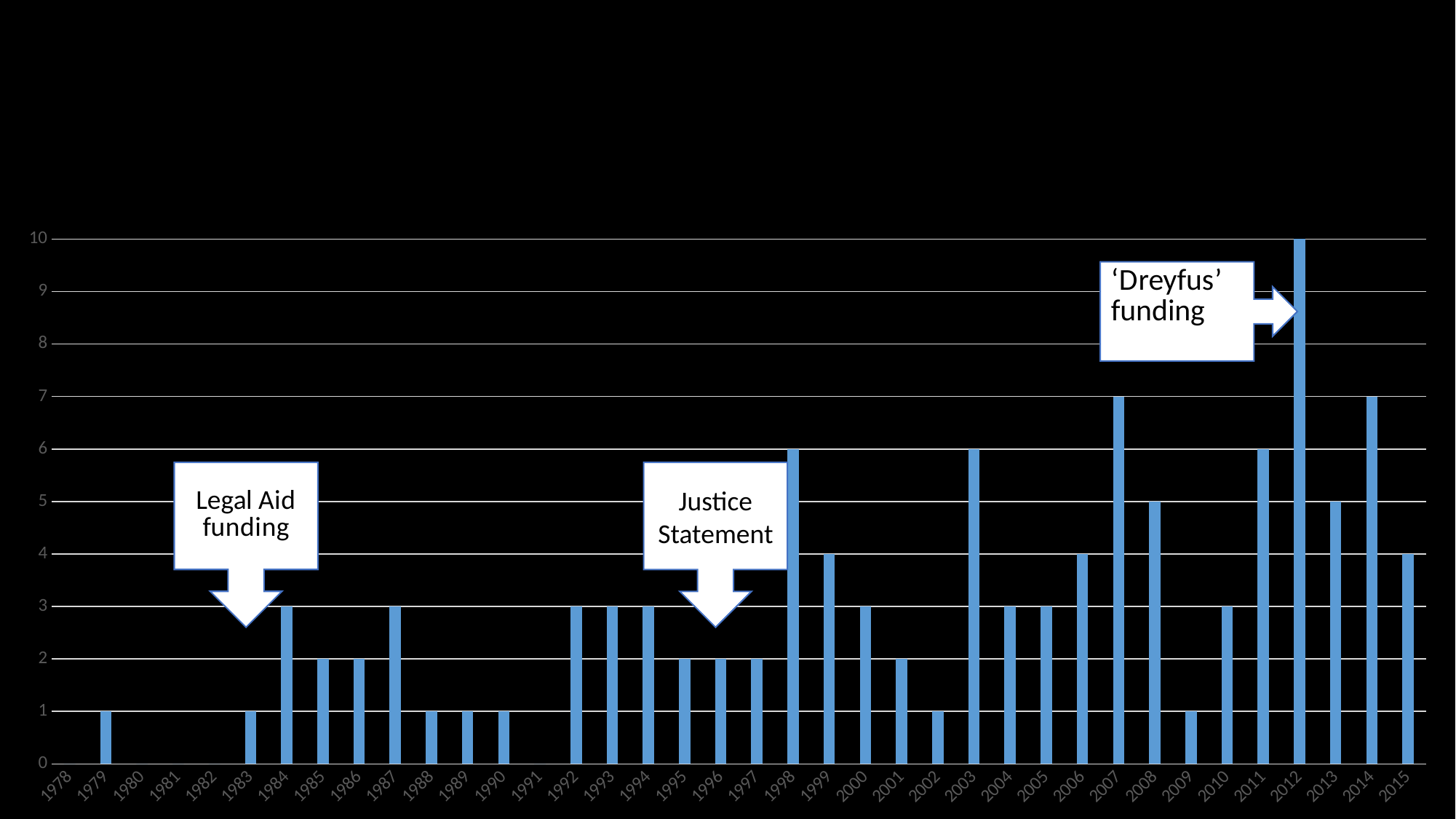
What type of chart is shown on the slide? bar chart Which year has the highest value in the chart? 2012 What is the value for 1998? 6 Which year does the 'Dreyfus' funding annotation point to? 2012 What is the difference between the values for 2012 and 2014? 3 Which is larger, the value for 2008 or the value for 2013? They are equal (5) What is the value for 2007? 7 What is the value for 2012? 10 Is the value for 2007 greater or less than 5? greater What is the value for 1984? 3 Which is larger, the value for 2011 or the value for 2010? 2011 How many years are shown on the x axis? 38